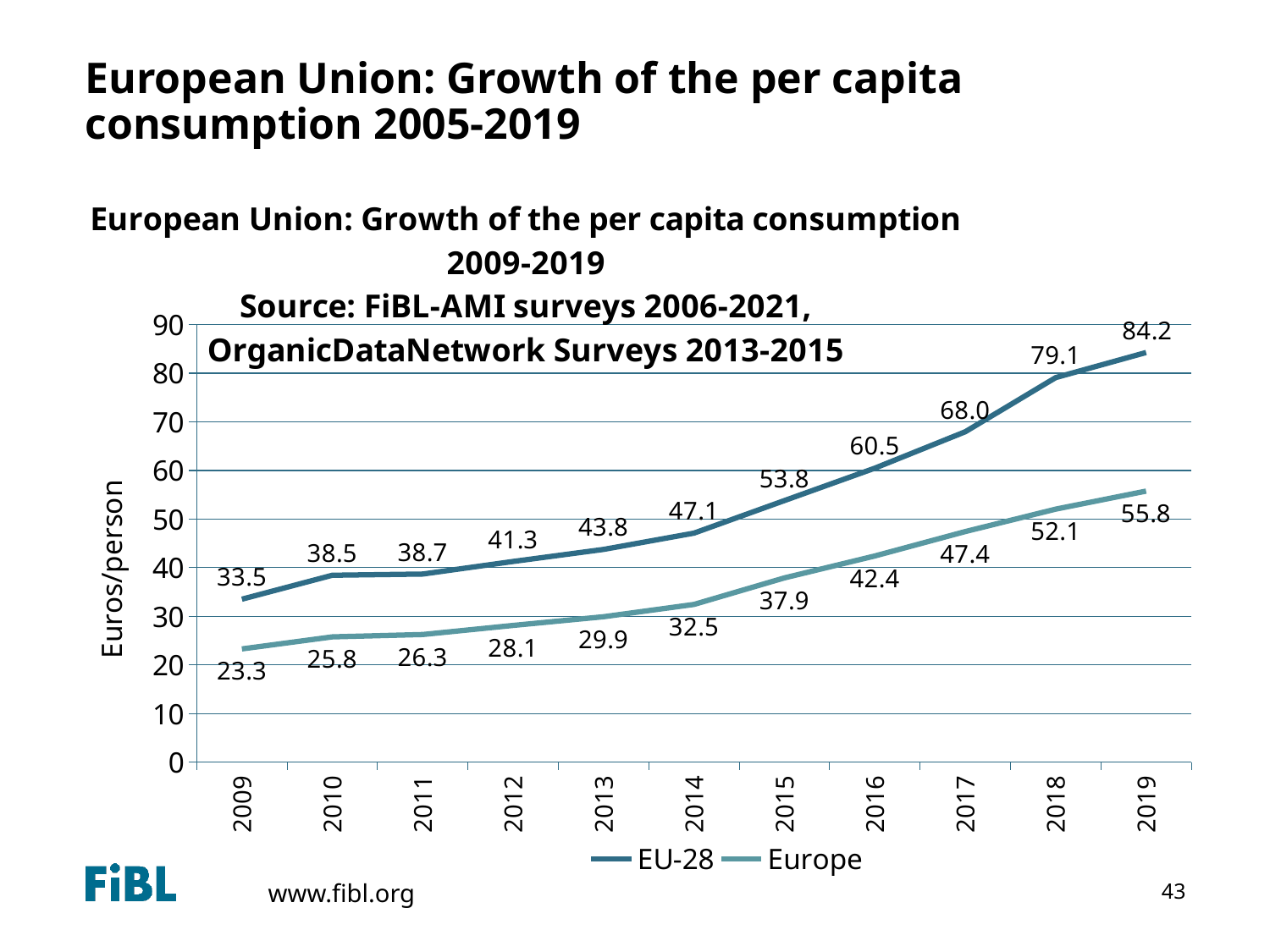
What is the difference between the EU-28 and Europe values in 2019? 28.4 What is the EU-28 value for 2014? 47.1 How many years are shown on the x axis? 11 What kind of chart is shown on the slide? Line chart In which year is the Europe value lowest? 2009 What is the Europe value for 2016? 42.4 Do the EU-28 values rise or fall from 2009 to 2019? Rise How many series does the legend list? 2 What is the Europe per capita consumption value for 2009? 23.3 In which year is the EU-28 value highest? 2019 Which series has the larger value in 2015, EU-28 or Europe? EU-28 What is the EU-28 per capita consumption value for 2019? 84.2